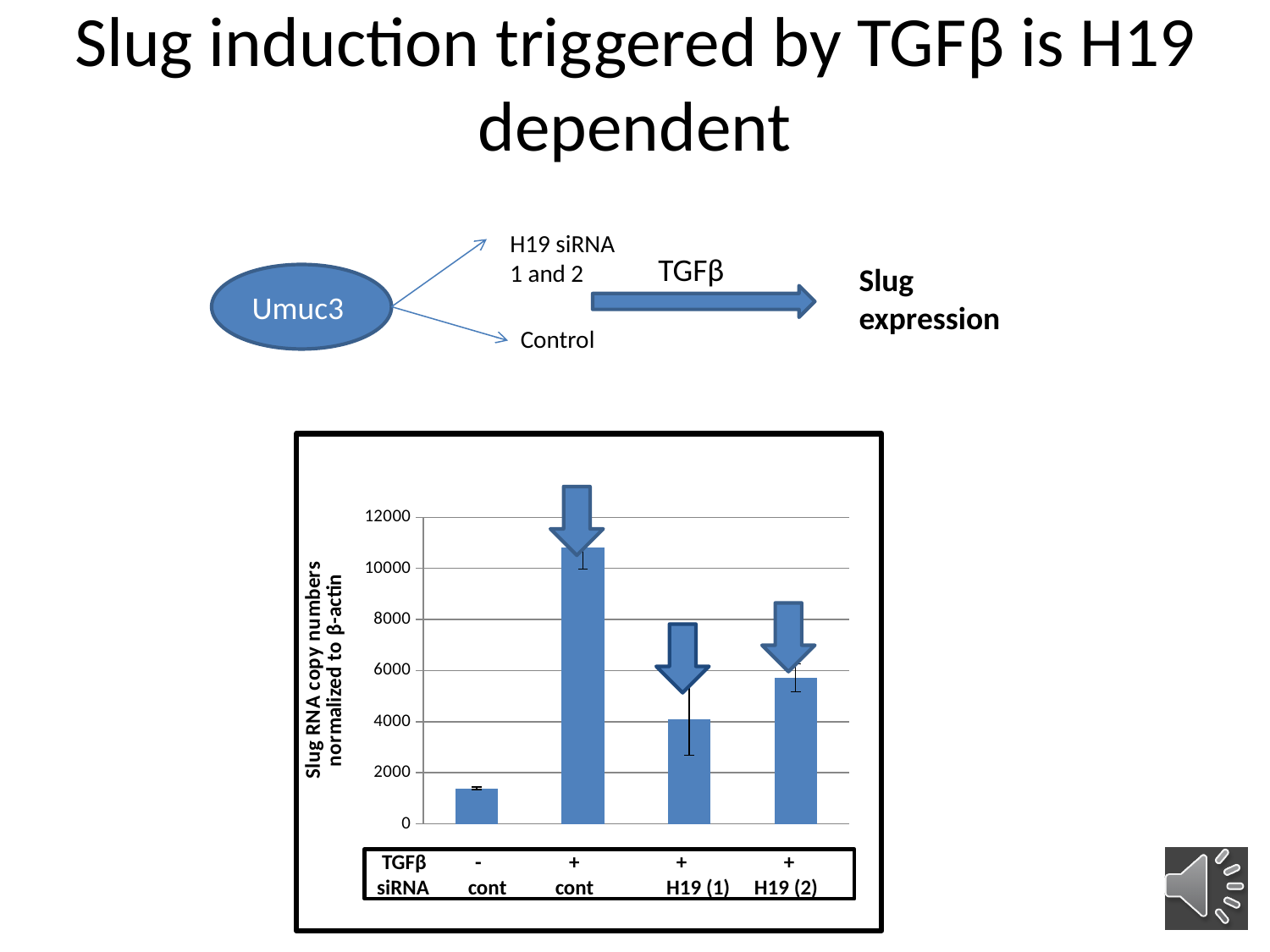
Is the value for the H19 (1) siRNA bar greater or less than 6000? less Is the value for the H19 (2) siRNA bar greater or less than 4000? greater Which is larger, the H19 (1) bar or the H19 (2) bar? H19 (2) Which condition has the highest Slug RNA copy number? cont siRNA with TGFβ (+) Which condition has the lowest Slug RNA copy number? cont siRNA without TGFβ (-) Which is larger, the cont siRNA with TGFβ (+) bar or the H19 (2) bar? cont siRNA with TGFβ (+) What kind of chart is shown on the slide? bar chart What is the label of the y axis of the chart? Slug RNA copy numbers normalized to β-actin Is the value for the cont siRNA with TGFβ (+) bar greater or less than 10000? greater What is the maximum value shown on the y axis of the chart? 12000 How many bars are plotted in the chart? 4